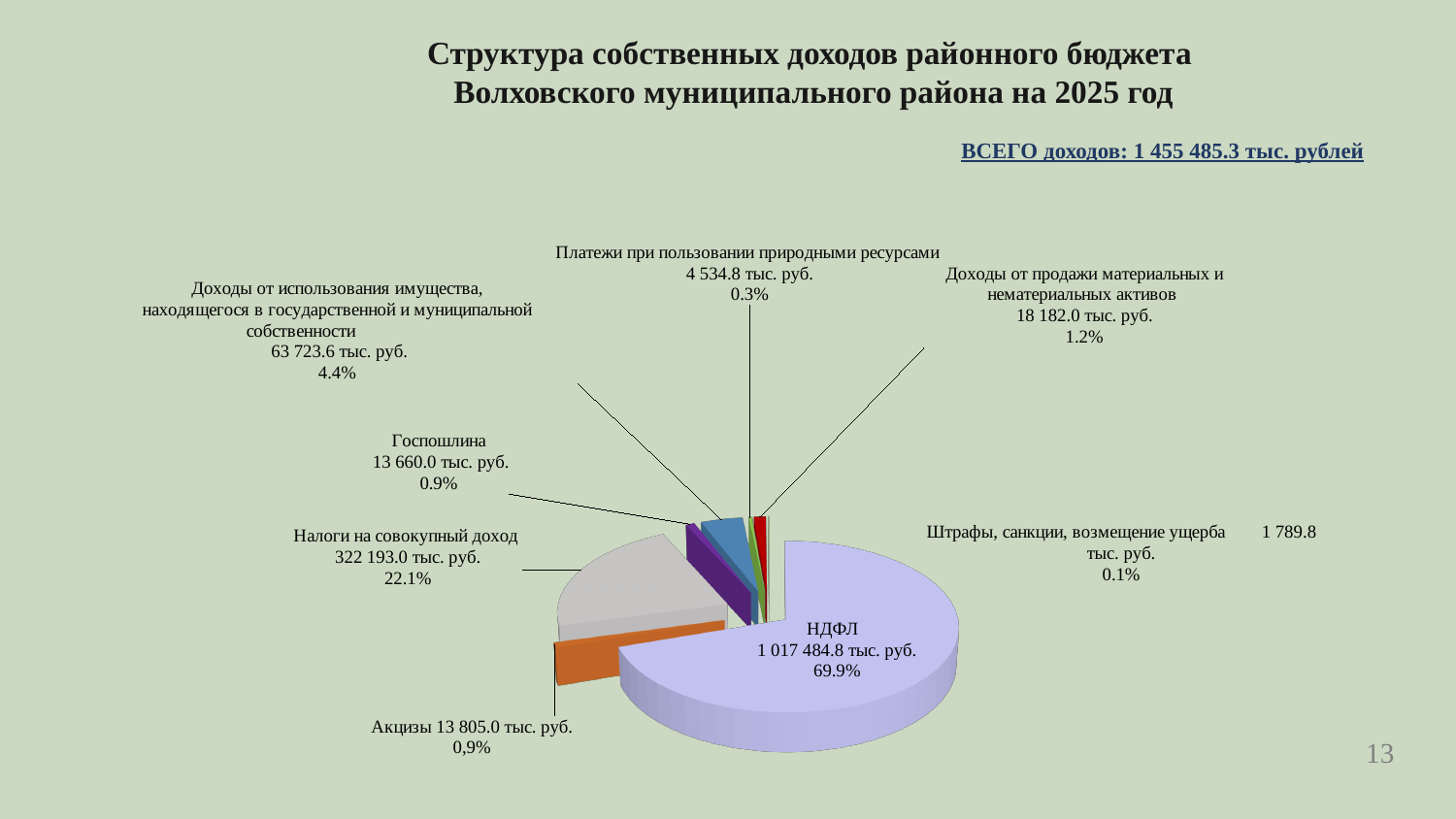
What share of the pie does НДФЛ represent? 69.9% What is the difference between the values for Налоги на совокупный доход and Доходы от использования имущества, находящегося в государственной и муниципальной собственности? 258 469.4 тыс. руб. How many slices does the pie chart have? 8 What is the value shown for Налоги на совокупный доход? 322 193.0 тыс. руб. What total income (ВСЕГО доходов) is stated on the slide? 1 455 485.3 тыс. рублей What kind of chart is shown on the slide? Pie chart What percentage is shown for Доходы от продажи материальных и нематериальных активов? 1.2% Which category has the smallest slice of the pie? Штрафы, санкции, возмещение ущерба Which category has the largest slice of the pie? НДФЛ What is the value shown for Платежи при пользовании природными ресурсами? 4 534.8 тыс. руб. What is the value shown for НДФЛ? 1 017 484.8 тыс. руб. Which is larger: Госпошлина or Акцизы? Акцизы